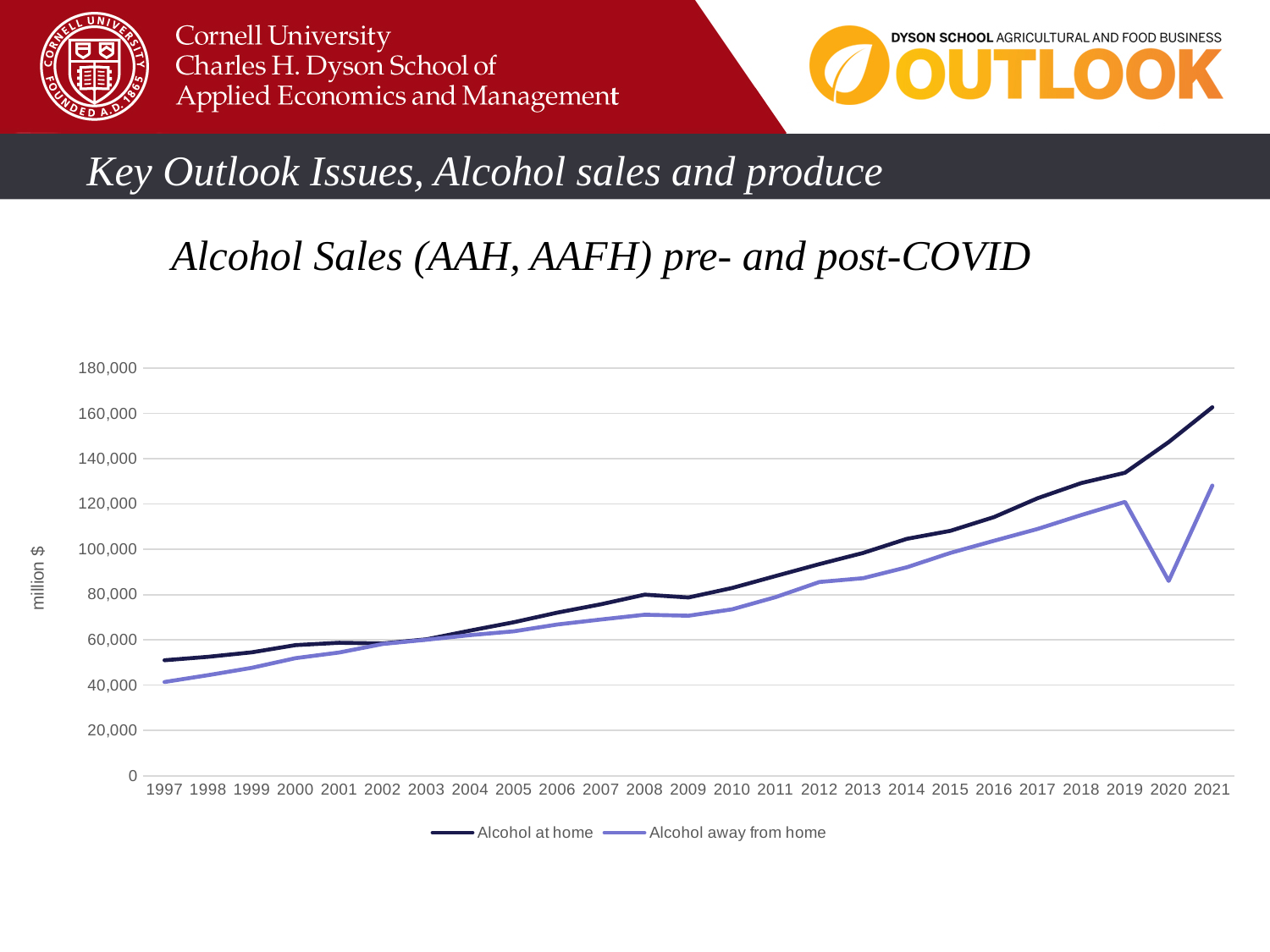
How many years are plotted along the x axis? 25 In 2020, which series has the larger value, Alcohol at home or Alcohol away from home? Alcohol at home What kind of chart is shown on the slide? Line chart What is the title of the chart? Alcohol Sales (AAH, AAFH) pre- and post-COVID In which year is the Alcohol at home series highest? 2021 Does the Alcohol away from home series rise or fall between 2019 and 2020? Fall In which year is the Alcohol away from home series lowest? 1997 Is the value for Alcohol away from home in 2020 greater or less than 100,000? less Is the value for Alcohol away from home in 2019 greater or less than 100,000? greater What is the label on the y axis? million $ Is the value for Alcohol at home in 2021 greater or less than 140,000? greater How many series does the legend list? 2